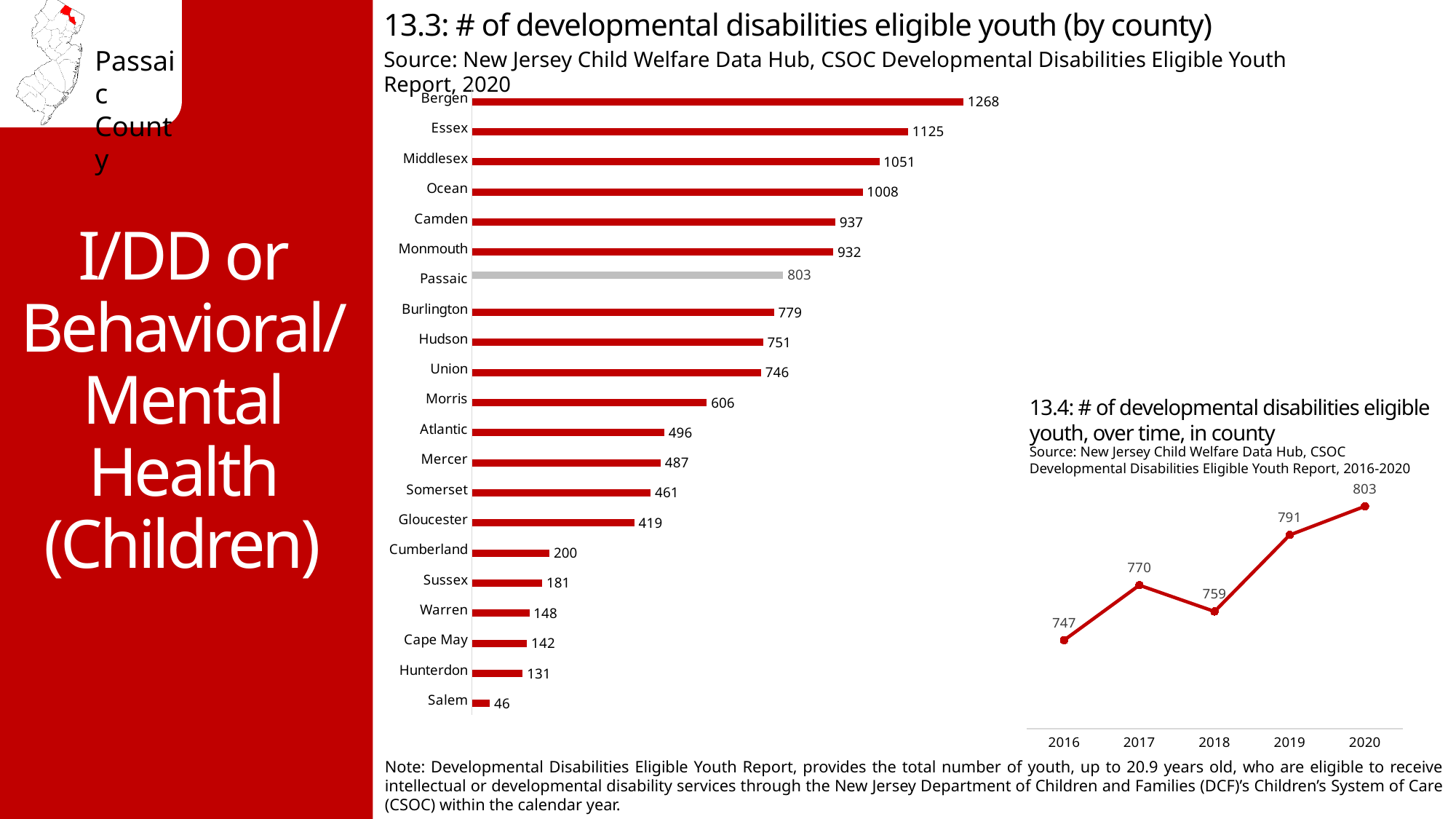
In chart 13.3 (by county), what is the value for Hunterdon? 131 In chart 13.3 (by county), which bar is shown in a different colour (grey) from the others? Passaic What kind of chart is chart 13.3 (by county)? Bar chart In chart 13.3 (by county), which county has the lowest number of developmental disabilities eligible youth? Salem In chart 13.3 (by county), which county has the highest number of developmental disabilities eligible youth? Bergen In chart 13.3 (# of developmental disabilities eligible youth by county), what is the value for Passaic? 803 In chart 13.4 (over time, in county), how many data points are plotted? 5 In chart 13.3 (by county), how many counties are shown? 21 In chart 13.3 (by county), what is the difference between the values for Bergen and Essex? 143 In chart 13.4 (over time, in county), what is the value for 2017? 770 In chart 13.4 (over time, in county), what is the difference between the 2020 and 2016 values? 56 In chart 13.3 (by county), which has a larger value, Camden or Monmouth? Camden